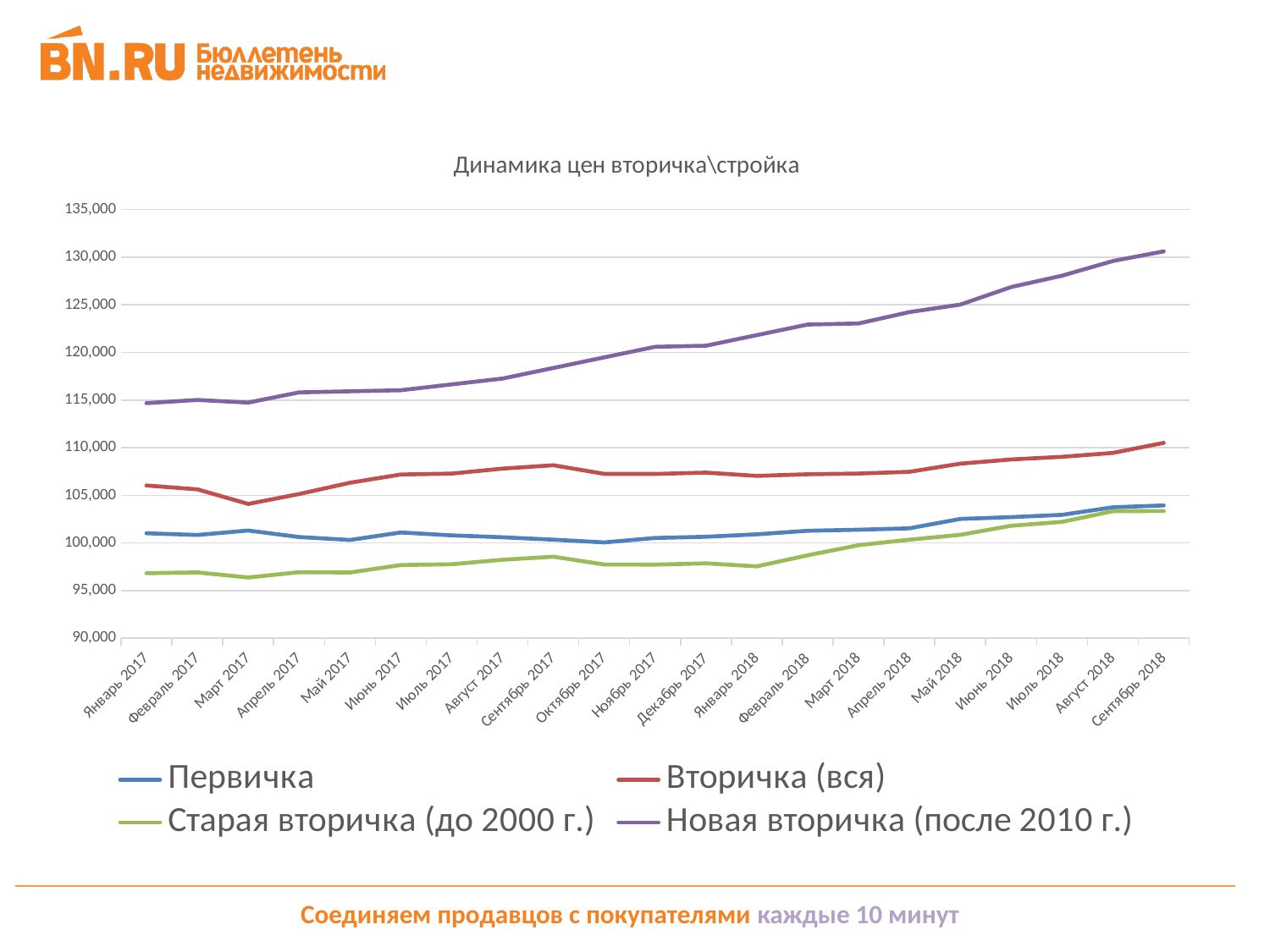
What is the title of the chart? Динамика цен вторичка\стройка In which month does the Вторичка (вся) series reach its lowest value? Март 2017 How many series does the legend list? 4 Is the value for Первичка in Сентябрь 2018 greater or less than 105,000? less What kind of chart is shown on the slide? line chart Which series has the highest value in Сентябрь 2018? Новая вторичка (после 2010 г.) Which series has the lowest value in Январь 2017? Старая вторичка (до 2000 г.) Is the value for Вторичка (вся) in Март 2017 greater or less than 105,000? less In Январь 2017, which is larger: Первичка or Старая вторичка (до 2000 г.)? Первичка Is the value for Новая вторичка (после 2010 г.) in Сентябрь 2018 greater or less than 125,000? greater Does the Новая вторичка (после 2010 г.) series rise or fall from Январь 2017 to Сентябрь 2018? rise How many months are shown on the x axis? 21